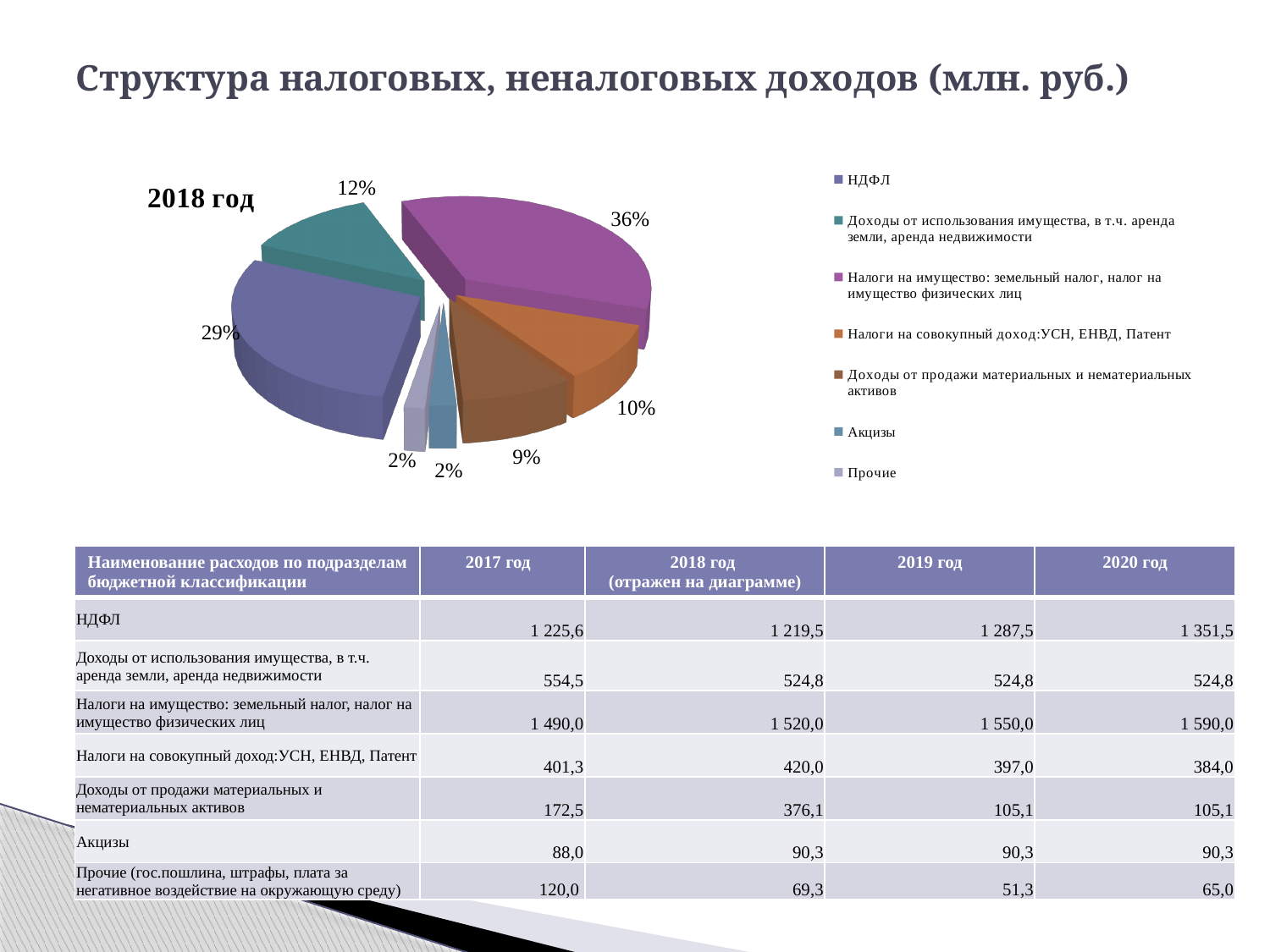
What share of the pie chart does the slice for Доходы от использования имущества, в т.ч. аренда земли, аренда недвижимости represent? 12% What share of the pie chart does the slice for Налоги на имущество: земельный налог, налог на имущество физических лиц represent? 36% How many entries does the legend of the pie chart list? 7 What share of the pie chart does the НДФЛ slice represent? 29% What kind of chart is shown on the slide? pie chart Which year does the pie chart represent? 2018 год Which slice is larger in the pie chart: НДФЛ or Налоги на имущество? Налоги на имущество Which category has the largest slice in the pie chart? Налоги на имущество: земельный налог, налог на имущество физических лиц By how many percentage points does the Налоги на имущество slice exceed the НДФЛ slice? 7